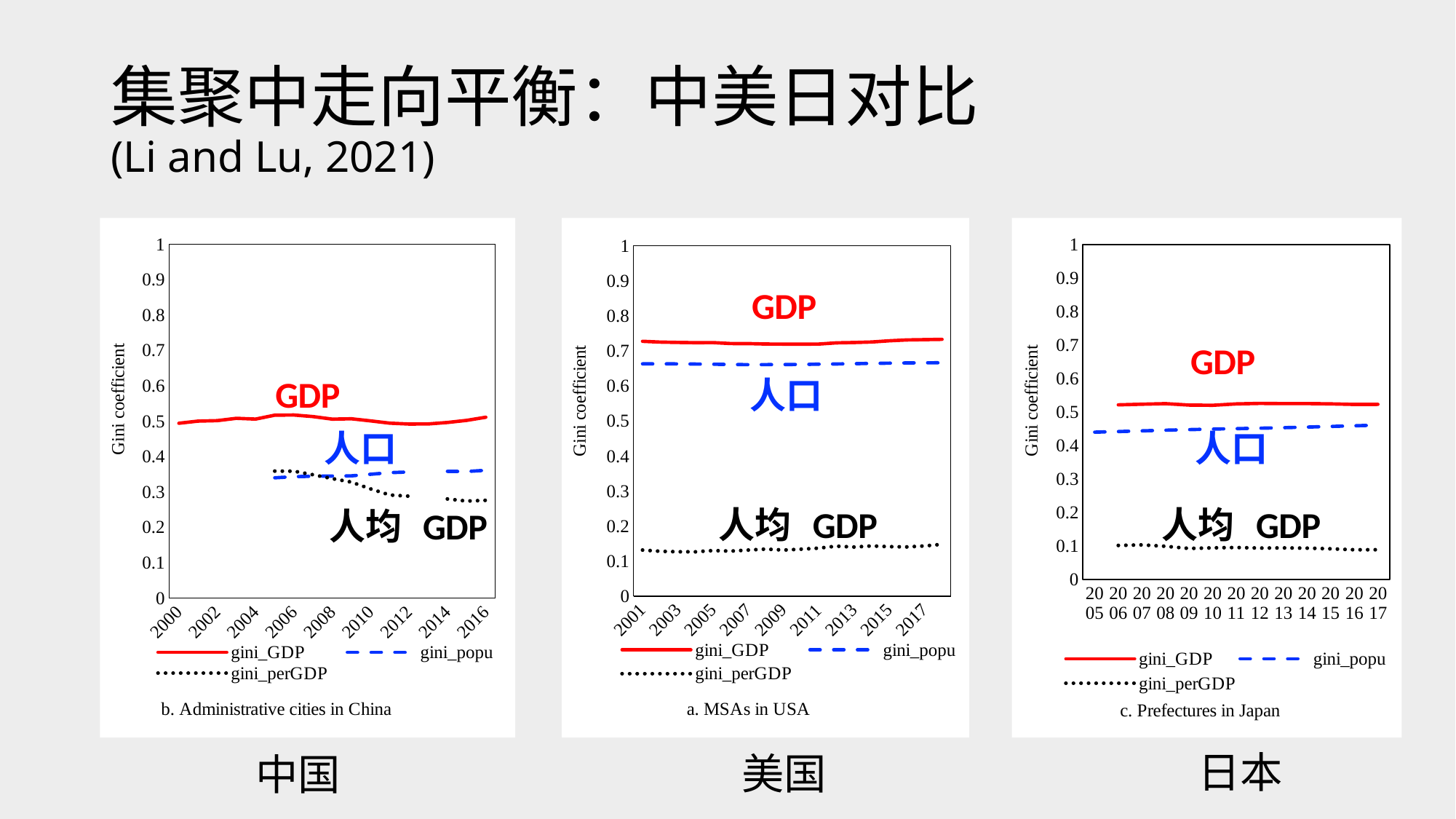
In the chart titled "c. Prefectures in Japan", which series has the lowest values? gini_perGDP How many series does the legend list in the chart titled "a. MSAs in USA"? 3 In the chart titled "c. Prefectures in Japan", is the value for gini_GDP greater or less than 0.5? greater In the chart titled "a. MSAs in USA", which series has higher values, gini_GDP or gini_popu? gini_GDP What kind of chart is the chart titled "b. Administrative cities in China"? line chart In the chart titled "c. Prefectures in Japan", is the value for gini_perGDP greater or less than 0.2? less In the chart titled "a. MSAs in USA", is the value for gini_perGDP greater or less than 0.2? less What is the y-axis label of the chart titled "a. MSAs in USA"? Gini coefficient In the chart titled "b. Administrative cities in China", which series is drawn as a dashed blue line? gini_popu In the chart titled "b. Administrative cities in China", does gini_perGDP rise or fall from 2005 to 2016? fall